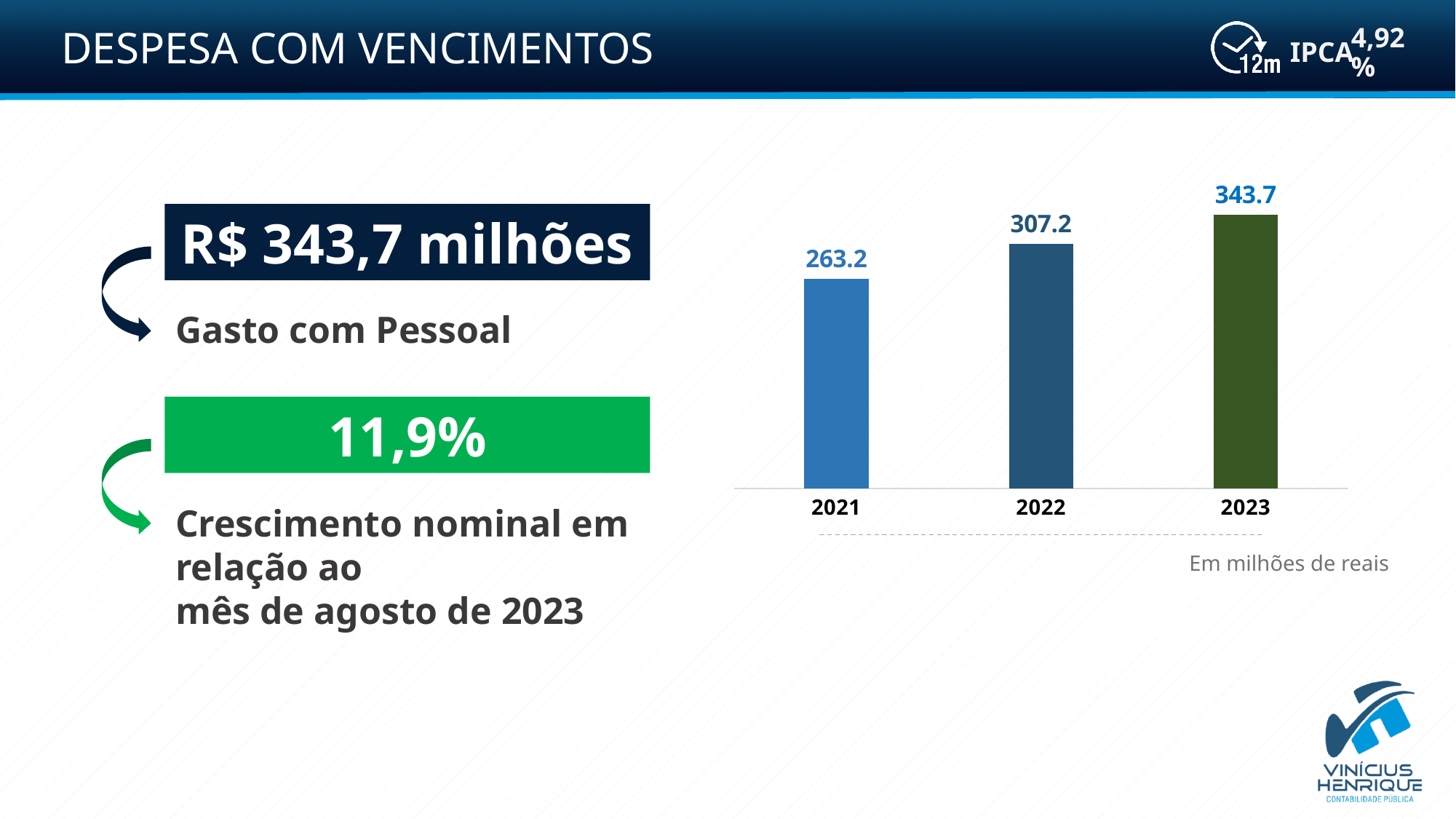
Do the values rise or fall from 2021 to 2023? rise What is the value for 2022 in the bar chart? 307.2 Which year has the lowest value in the bar chart? 2021 Which year has the highest value in the bar chart? 2023 What is the value for 2023 in the bar chart? 343.7 Which is larger, the value for 2021 or the value for 2022? 2022 What is the difference between the values for 2022 and 2021? 44.0 What is the difference between the values for 2023 and 2022? 36.5 What is the value for 2021 in the bar chart? 263.2 How many bars are shown in the chart? 3 What unit does the note below the chart say the values are in? Em milhões de reais What kind of chart is shown on the slide? bar chart